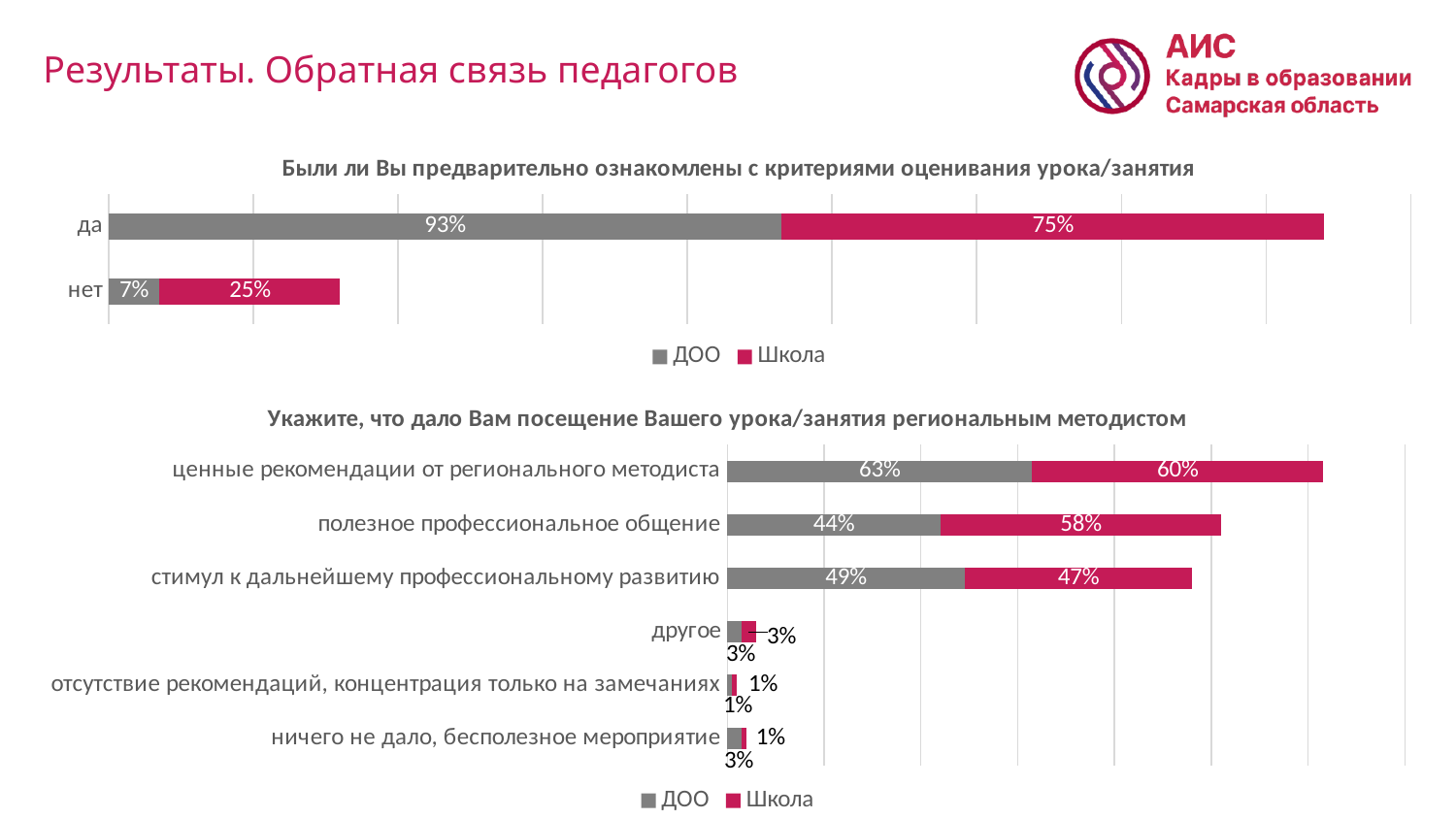
In the top chart 'Были ли Вы предварительно ознакомлены с критериями оценивания урока/занятия', what is the ДОО value for 'да'? 93% In the bottom chart, what is the ДОО value for 'стимул к дальнейшему профессиональному развитию'? 49% In the bottom chart, what is the total of the stacked bar for 'ценные рекомендации от регионального методиста'? 123% In the bottom chart, which is larger for 'полезное профессиональное общение': the ДОО value or the Школа value? Школа In the top chart, what is the Школа value for 'нет'? 25% What type of chart is the top chart? Stacked bar chart In the bottom chart, which category has the highest ДОО value? ценные рекомендации от регионального методиста In the top chart, what is the total of the stacked bar for 'да'? 168% In the top chart, what is the difference between the ДОО and Школа values for 'нет'? 18% In the bottom chart, what is the Школа value for 'полезное профессиональное общение'? 58% How many categories are shown in the bottom chart 'Укажите, что дало Вам посещение Вашего урока/занятия региональным методистом'? 6 How many series does the legend of the bottom chart list? 2